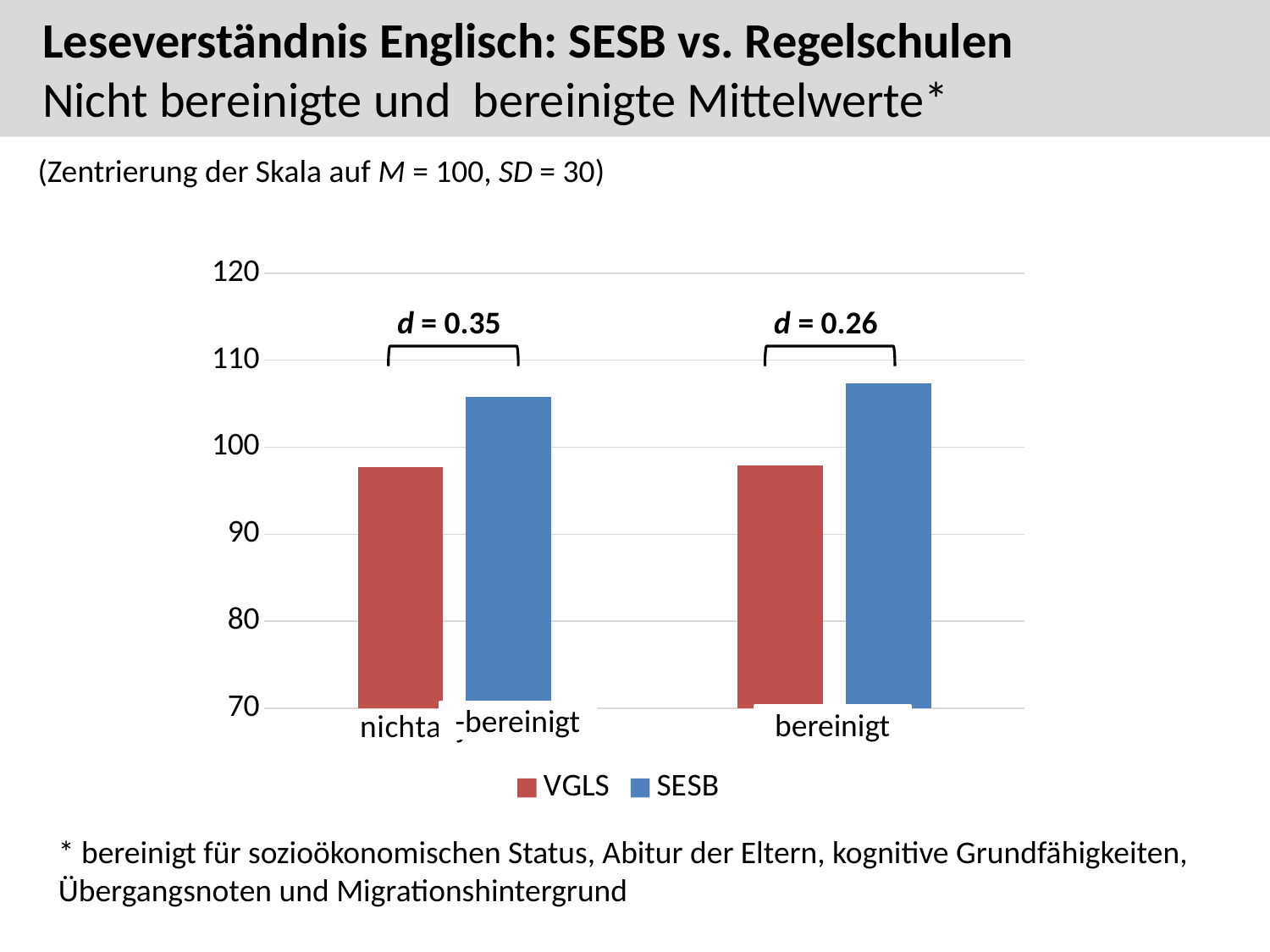
Is the value for VGLS in the 'nicht bereinigt' category greater or less than 100? less What kind of chart is shown on the slide? bar chart Which colour represents the SESB series in the chart? blue How many categories are shown on the x axis? 2 Is the value for SESB in the 'bereinigt' category greater or less than 100? greater Is the value for VGLS in the 'bereinigt' category greater or less than 90? greater What effect size d is printed above the 'nicht bereinigt' pair of bars? d = 0.35 How many series does the legend list? 2 In the 'nicht bereinigt' category, which series has the larger value, VGLS or SESB? SESB In the 'bereinigt' category, which series has the larger value, VGLS or SESB? SESB